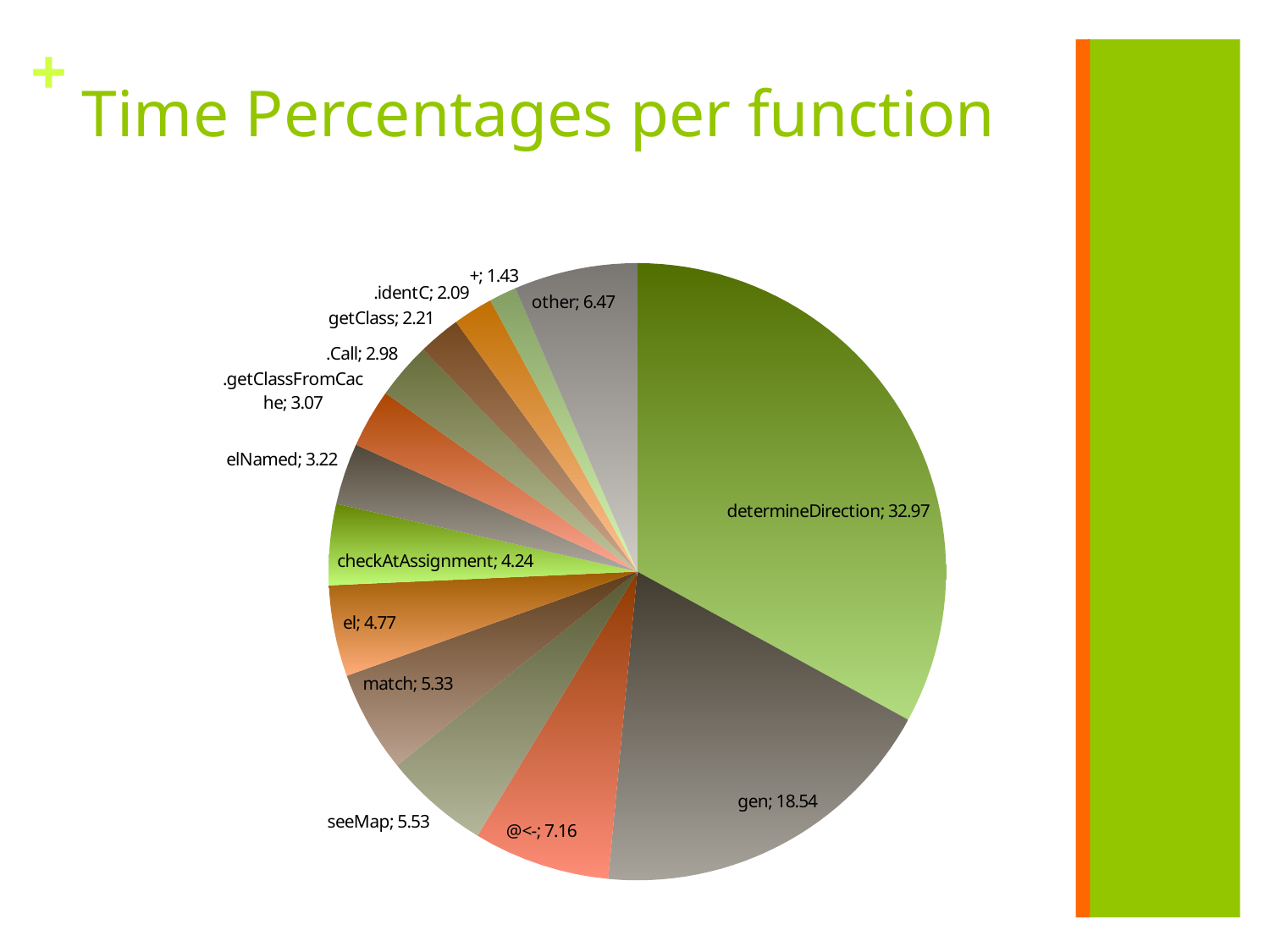
What kind of chart is shown on the slide? pie chart What value is shown for the 'other' slice? 6.47 How many slices does the pie chart have? 14 Which slice has the smallest value? + What is the title of the chart? Time Percentages per function What value is shown for gen? 18.54 Which function has the largest slice of the pie? determineDirection What value is shown for seeMap? 5.53 What value is shown for checkAtAssignment? 4.24 Which is larger, the value for match or the value for el? match What value is shown for determineDirection? 32.97 What is the difference between the values for determineDirection and gen? 14.43